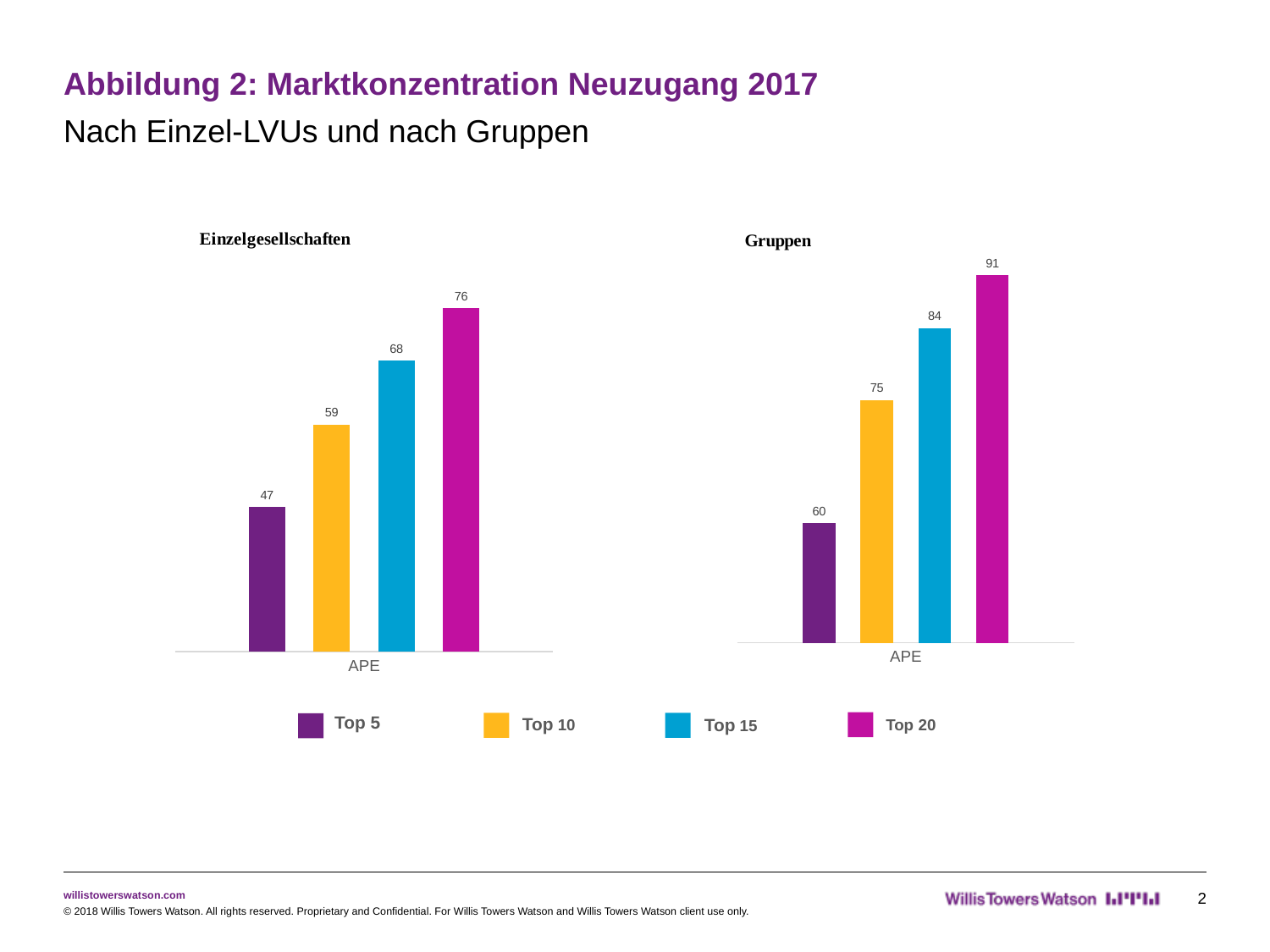
Which is larger: the Top 10 value in the Einzelgesellschaften chart or the Top 10 value in the Gruppen chart? Gruppen In the Gruppen chart, what is the value for Top 20? 91 In the Gruppen chart, what is the difference between the Top 15 and Top 10 values? 9 In the Einzelgesellschaften chart, what is the difference between the Top 20 and Top 5 values? 29 How many series does the legend list? 4 What kind of chart is the Gruppen chart? Bar chart In the Einzelgesellschaften chart, what is the value for Top 5? 47 In the Einzelgesellschaften chart, what is the value for Top 15? 68 In the Gruppen chart, which series has the lowest value? Top 5 In the Gruppen chart, what is the value for Top 10? 75 In the Einzelgesellschaften chart, do the values rise or fall from Top 5 to Top 20? Rise In the Einzelgesellschaften chart, which series has the highest value? Top 20